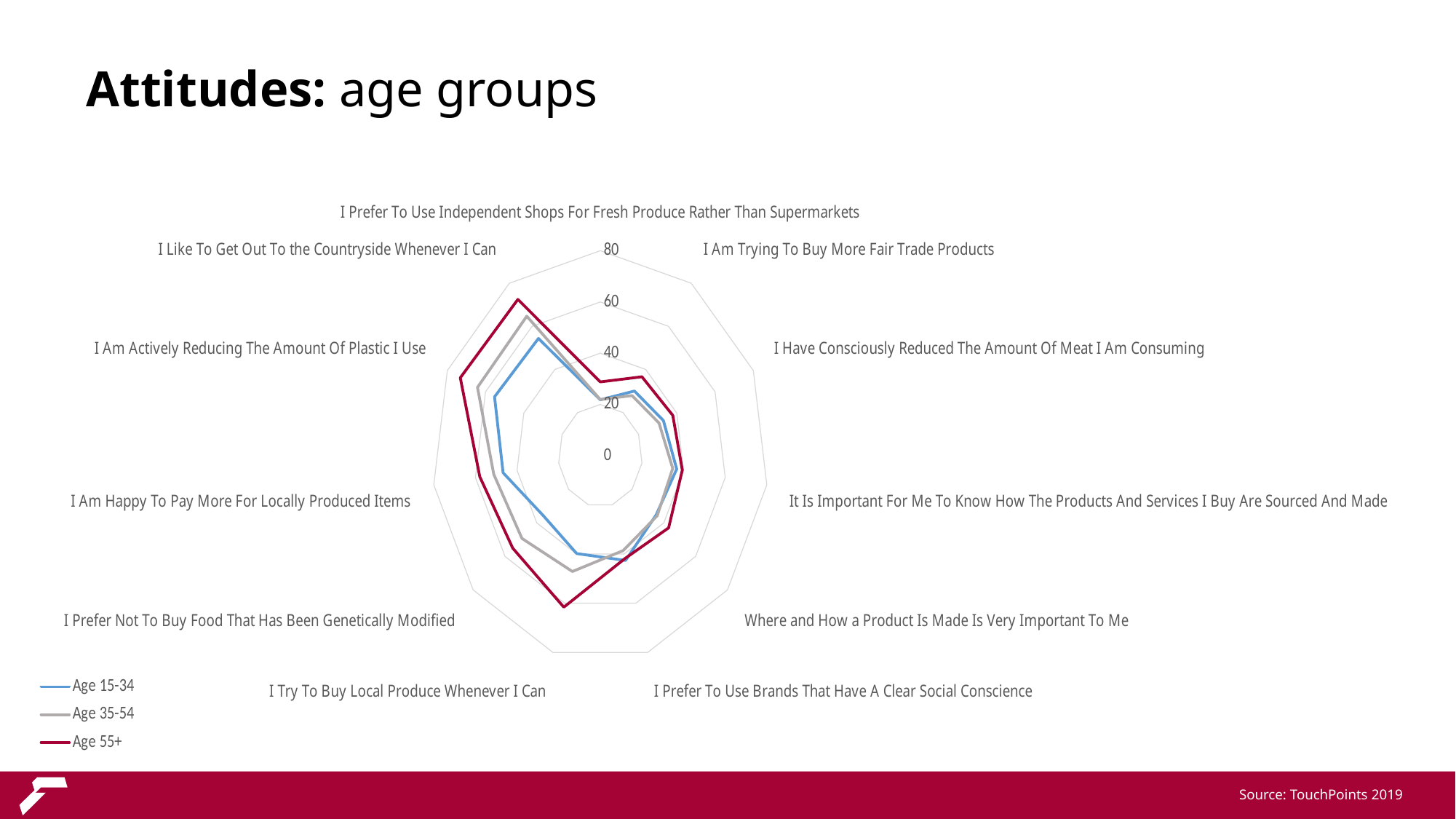
For "I Am Happy To Pay More For Locally Produced Items", which is larger: the value for Age 55+ or the value for Age 15-34? Age 55+ What kind of chart is shown on the slide? Radar chart Which age group has the highest value for "I Am Actively Reducing The Amount Of Plastic I Use"? Age 55+ How many attitude statements (categories) are plotted on the radar chart? 11 Is the value for Age 55+ on "I Like To Get Out To the Countryside Whenever I Can" greater or less than 60? greater Is the value for Age 15-34 on "I Like To Get Out To the Countryside Whenever I Can" greater or less than 60? less Which age group has the lowest value for "I Like To Get Out To the Countryside Whenever I Can"? Age 15-34 What is the highest value shown on the radar chart's axis scale? 80 Which age group is shown by the red line in the legend? Age 55+ How many series does the legend list? 3 Is the value for Age 55+ on "I Try To Buy Local Produce Whenever I Can" greater or less than 40? greater